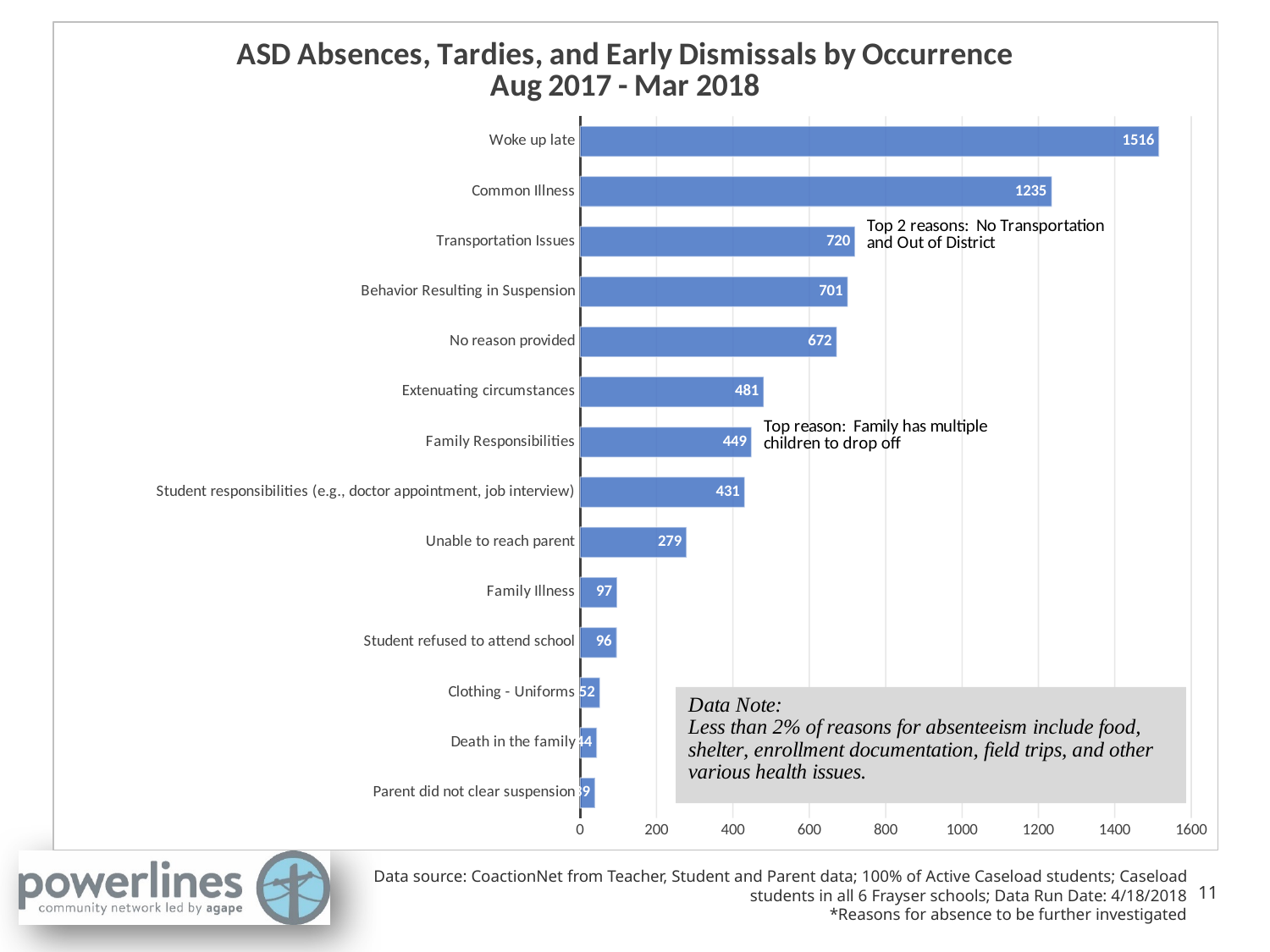
What is the difference between 'Woke up late' and 'Common Illness'? 281 Is the value for 'Student responsibilities (e.g., doctor appointment, job interview)' greater or less than 600? less What is the value for 'Transportation Issues'? 720 How many reason categories are plotted in the chart? 14 What is the value for 'Common Illness'? 1235 What is the difference between 'Behavior Resulting in Suspension' and 'No reason provided'? 29 What kind of chart is shown on the slide? bar chart What is the title of the chart? ASD Absences, Tardies, and Early Dismissals by Occurrence Aug 2017 - Mar 2018 Which reason has the highest number of occurrences? Woke up late How many occurrences are recorded for 'Woke up late'? 1516 What is the value for 'Unable to reach parent'? 279 Which is larger, 'Extenuating circumstances' or 'Family Responsibilities'? Extenuating circumstances